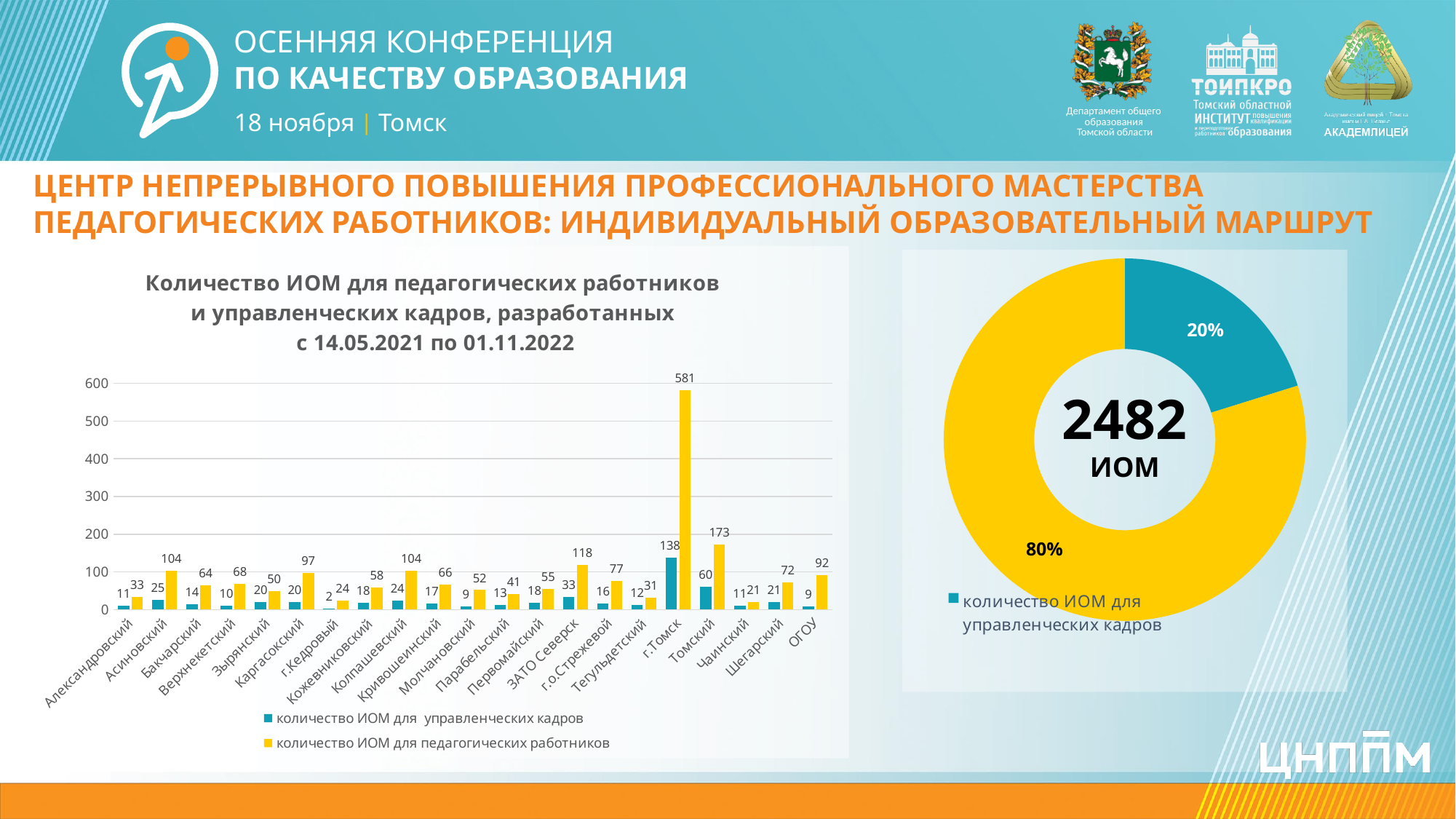
On the bar chart, which category has the highest value for ИОМ для педагогических работников? г.Томск On the bar chart, how many series does the legend list? 2 On the bar chart, how many categories are shown on the x axis? 21 On the bar chart, which is larger: the ИОМ для педагогических работников value for ЗАТО Северск or for Асиновский? ЗАТО Северск On the donut chart, what share is shown for количество ИОМ для управленческих кадров? 20% What total number is shown in the centre of the donut chart? 2482 What kind of chart is the one on the left of the slide? Bar chart On the bar chart, which category has the lowest value for ИОМ для управленческих кадров? г.Кедровый On the bar chart, how many ИОМ for педагогических работников were developed in г.Томск? 581 On the bar chart, what is the total of the two series for Шегарский? 93 On the bar chart, how many ИОМ for управленческих кадров were developed in Томский? 60 On the bar chart, what is the difference between the ИОМ для педагогических работников values for г.Томск and Томский? 408